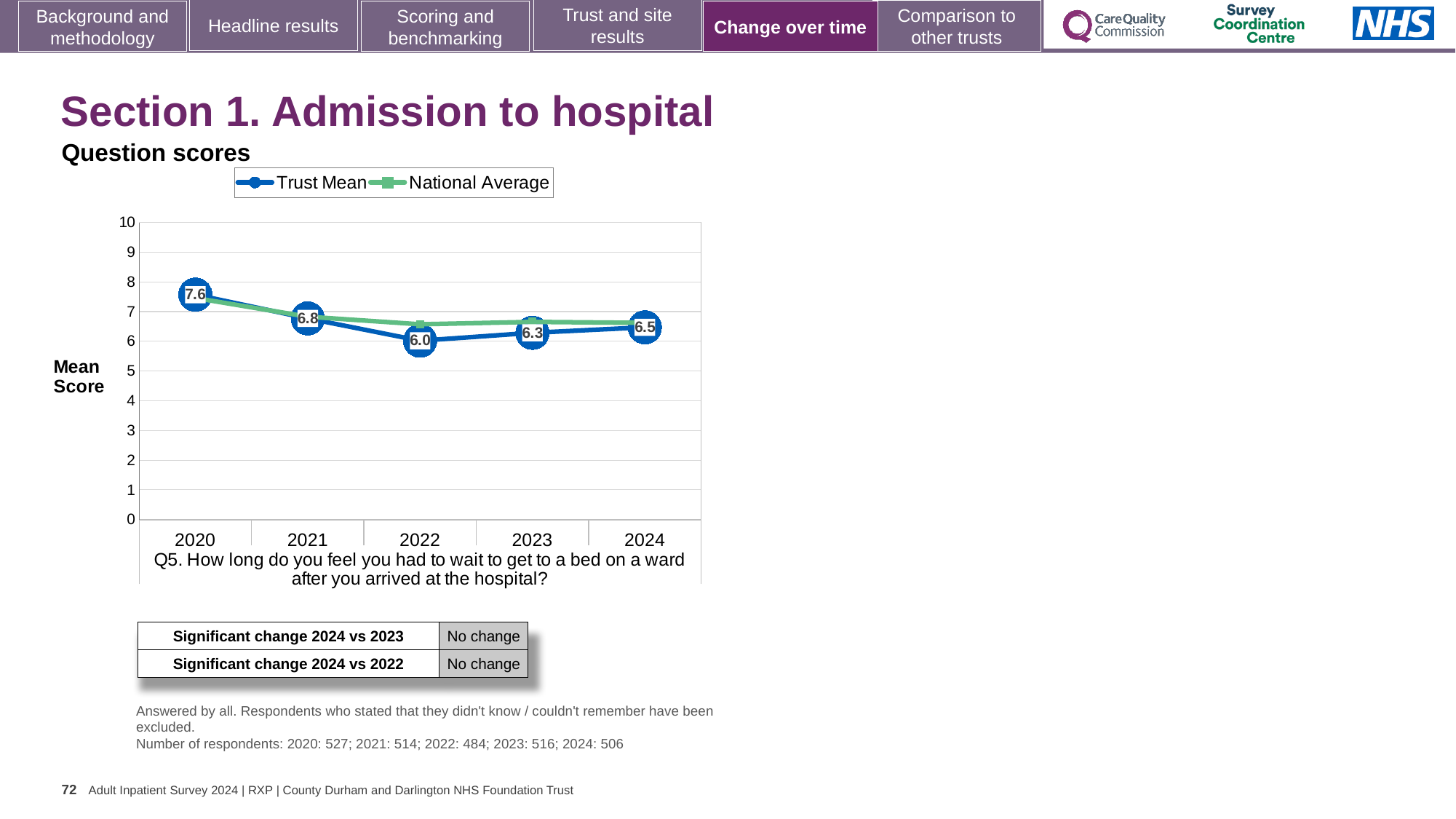
What is the Trust Mean score for 2024? 6.5 Does the Trust Mean score rise or fall from 2020 to 2022? Fall Is the National Average for 2022 greater or less than 6? greater How many years are plotted on the x axis? 5 In which year is the Trust Mean score highest? 2020 Which is larger, the Trust Mean score for 2023 or for 2024? 2024 What is the Trust Mean score for 2020? 7.6 What is the difference between the Trust Mean scores for 2020 and 2021? 0.8 What kind of chart is shown? Line chart What is the Trust Mean score for 2022? 6.0 How many series does the legend list? 2 In which year is the Trust Mean score lowest? 2022